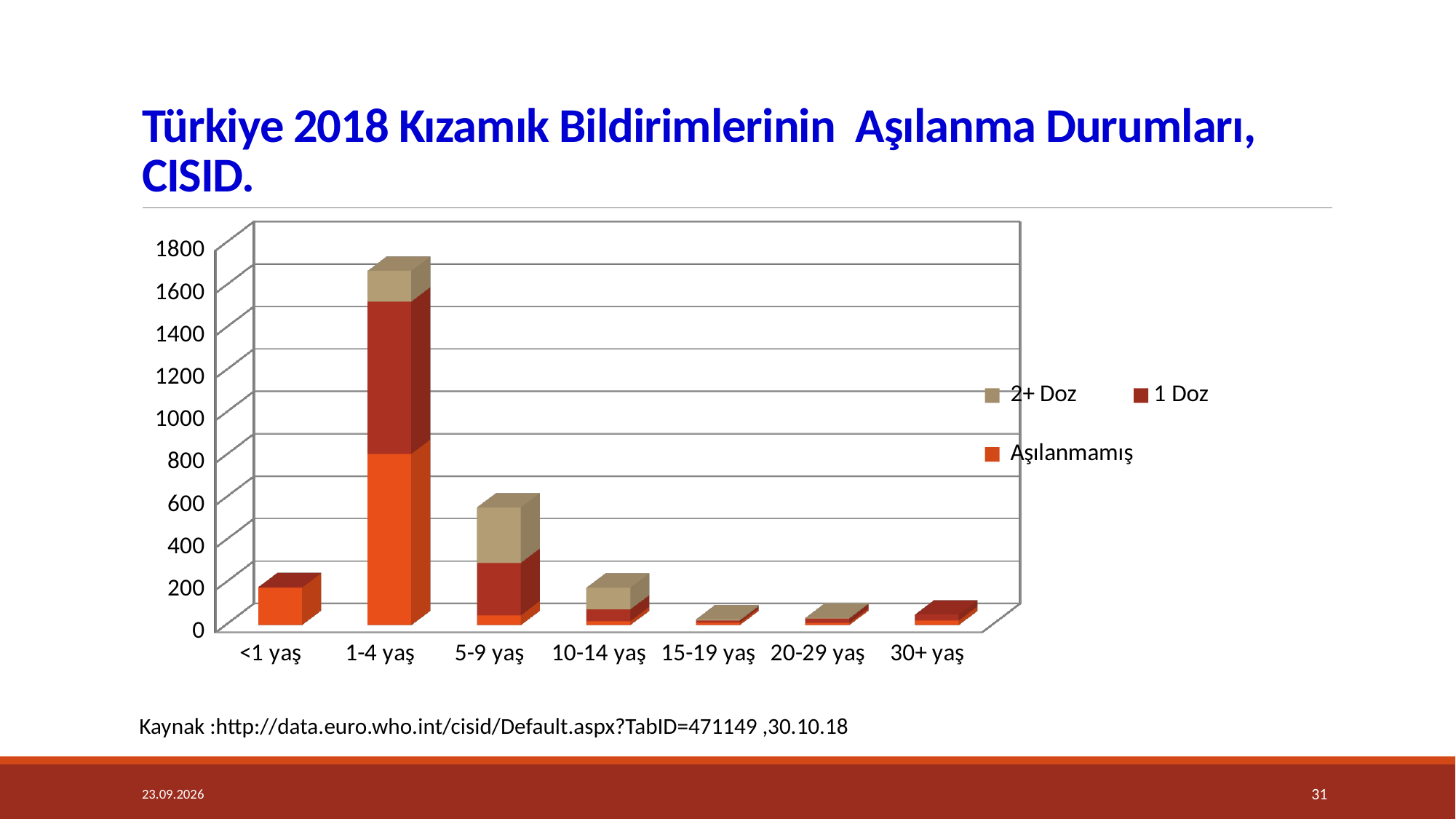
How many age categories are shown on the x axis? 7 Is the total value for 1-4 yaş greater or less than 1400? greater Which has the larger stacked bar, 1-4 yaş or 5-9 yaş? 1-4 yaş What kind of chart is shown on the slide? Stacked bar chart Which series is shown in orange in the legend? Aşılanmamış Is the total value for 5-9 yaş greater or less than 400? greater Which age category has the tallest stacked bar? 1-4 yaş What are the three series listed in the legend? 2+ Doz, 1 Doz, Aşılanmamış Which has the larger stacked bar, 5-9 yaş or 10-14 yaş? 5-9 yaş Is the total value for 10-14 yaş greater or less than 400? less How many series does the legend list? 3